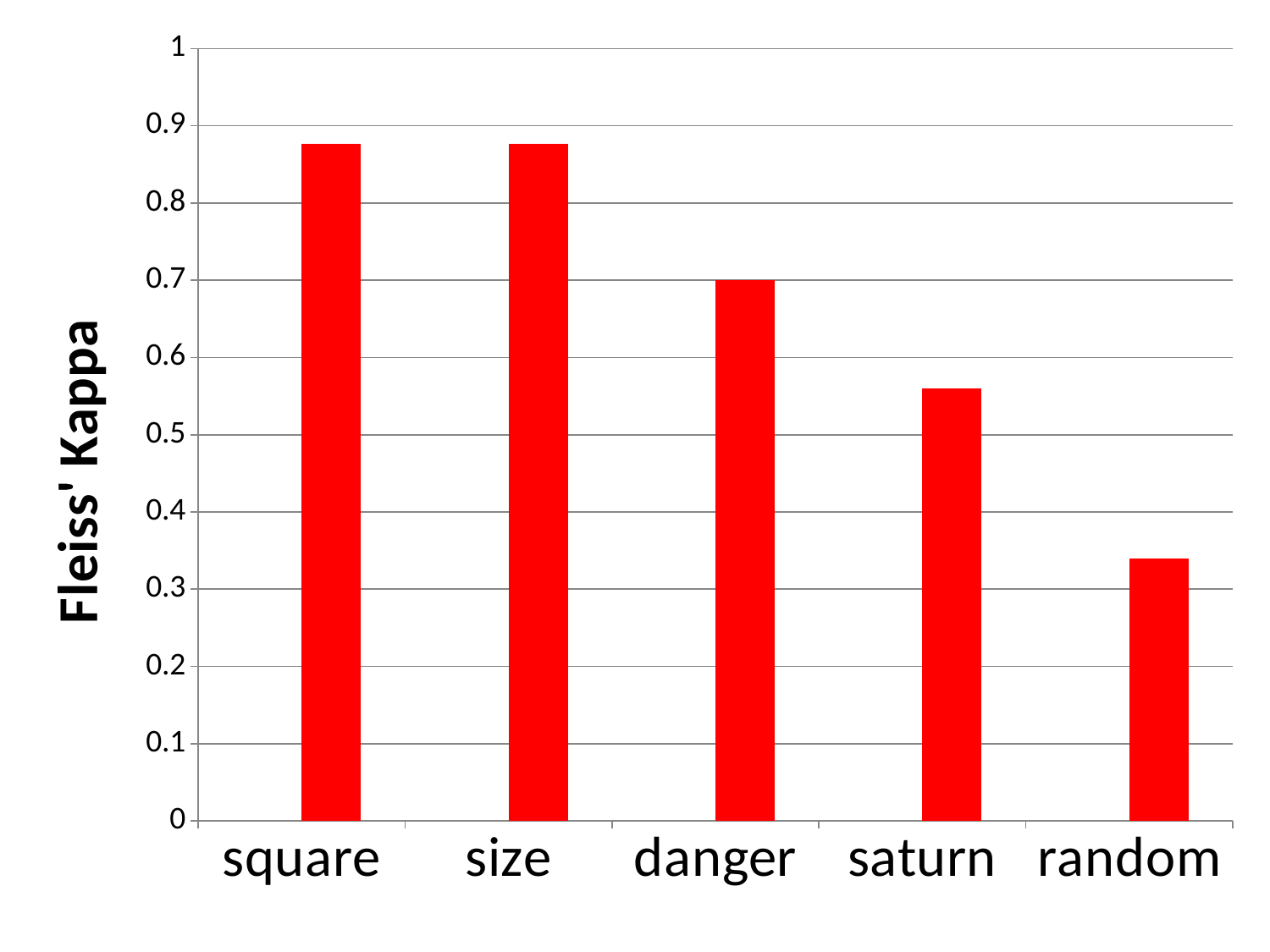
Is the value for random greater or less than 0.3? greater Which has a higher Fleiss' Kappa, size or random? size Is the value for random greater or less than 0.4? less Is the value for square greater or less than 0.8? greater What is the Fleiss' Kappa value for danger? 0.7 Do the values rise or fall moving from left to right along the x axis? fall What is the label on the y axis? Fleiss' Kappa What kind of chart is shown on the slide? bar chart Which has a higher Fleiss' Kappa, danger or saturn? danger How many categories are shown on the x axis? 5 Which category has the lowest Fleiss' Kappa? random